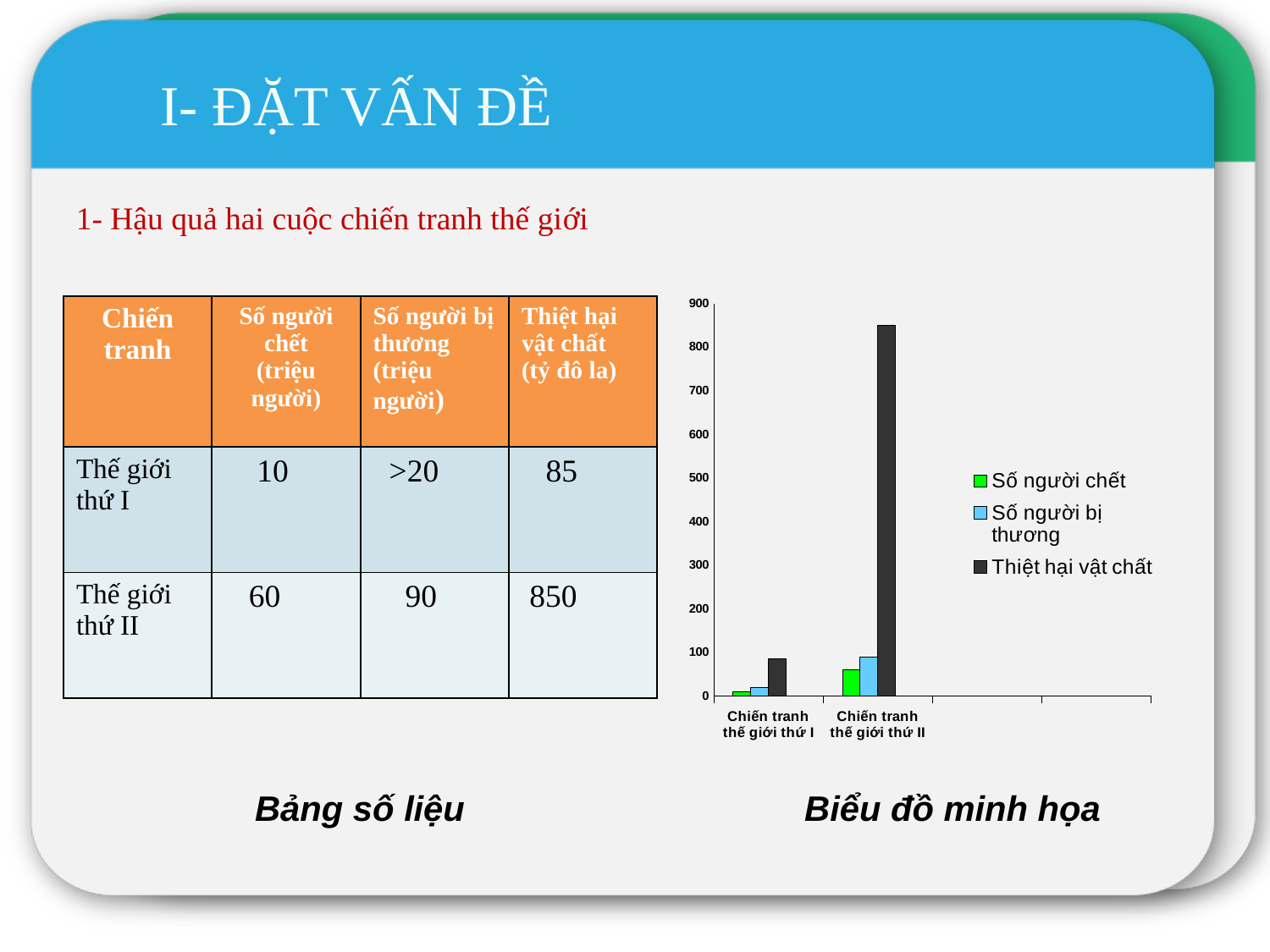
In the chart, which series has the tallest bar for Chiến tranh thế giới thứ II? Thiệt hại vật chất In the chart, which is larger for Chiến tranh thế giới thứ II: Số người bị thương or Thiệt hại vật chất? Thiệt hại vật chất In the chart, is the value of Thiệt hại vật chất for Chiến tranh thế giới thứ II greater or less than 800? greater In the chart, do the values for each series rise or fall from Chiến tranh thế giới thứ I to Chiến tranh thế giới thứ II? rise In the chart, which bar is the lowest overall? Số người chết for Chiến tranh thế giới thứ I In the chart, is the value of Thiệt hại vật chất for Chiến tranh thế giới thứ I greater or less than 100? less What kind of chart is shown on the right of the slide? bar chart What colour represents Số người chết in the chart's legend? green In the chart, which is larger: Số người chết for Chiến tranh thế giới thứ I or for Chiến tranh thế giới thứ II? Chiến tranh thế giới thứ II How many series does the chart's legend list? 3 How many categories are shown on the x axis of the chart? 2 In the chart, is the value of Số người chết for Chiến tranh thế giới thứ II greater or less than 100? less